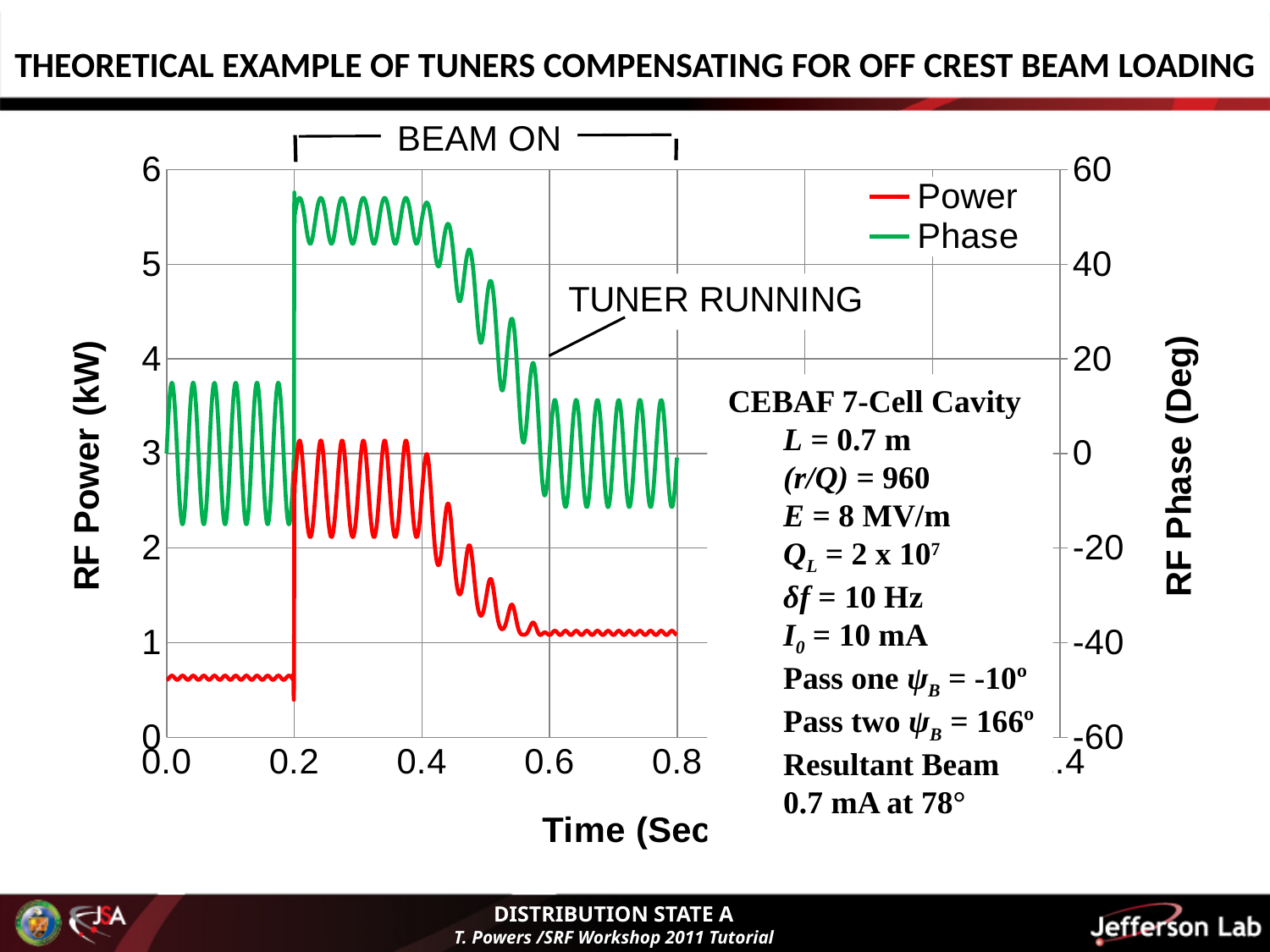
Is the Phase value at 0.3 seconds greater or less than 40 degrees? greater Does the Power series rise or fall between 0.4 and 0.6 seconds? fall Is the Phase value at 0.7 seconds greater or less than 20 degrees? less Is the Phase value at 0.3 seconds larger or smaller than the Phase value at 0.7 seconds? larger How many series does the legend list? 2 Is the Power value at 0.3 seconds greater or less than 2 kW? greater Is the Power value at 0.3 seconds larger or smaller than the Power value at 0.1 seconds? larger Which series is drawn in red? Power What kind of chart is shown on the slide? Line chart What is the title of the right-hand vertical axis? RF Phase (Deg) Does the Phase series rise or fall between 0.4 and 0.6 seconds? fall